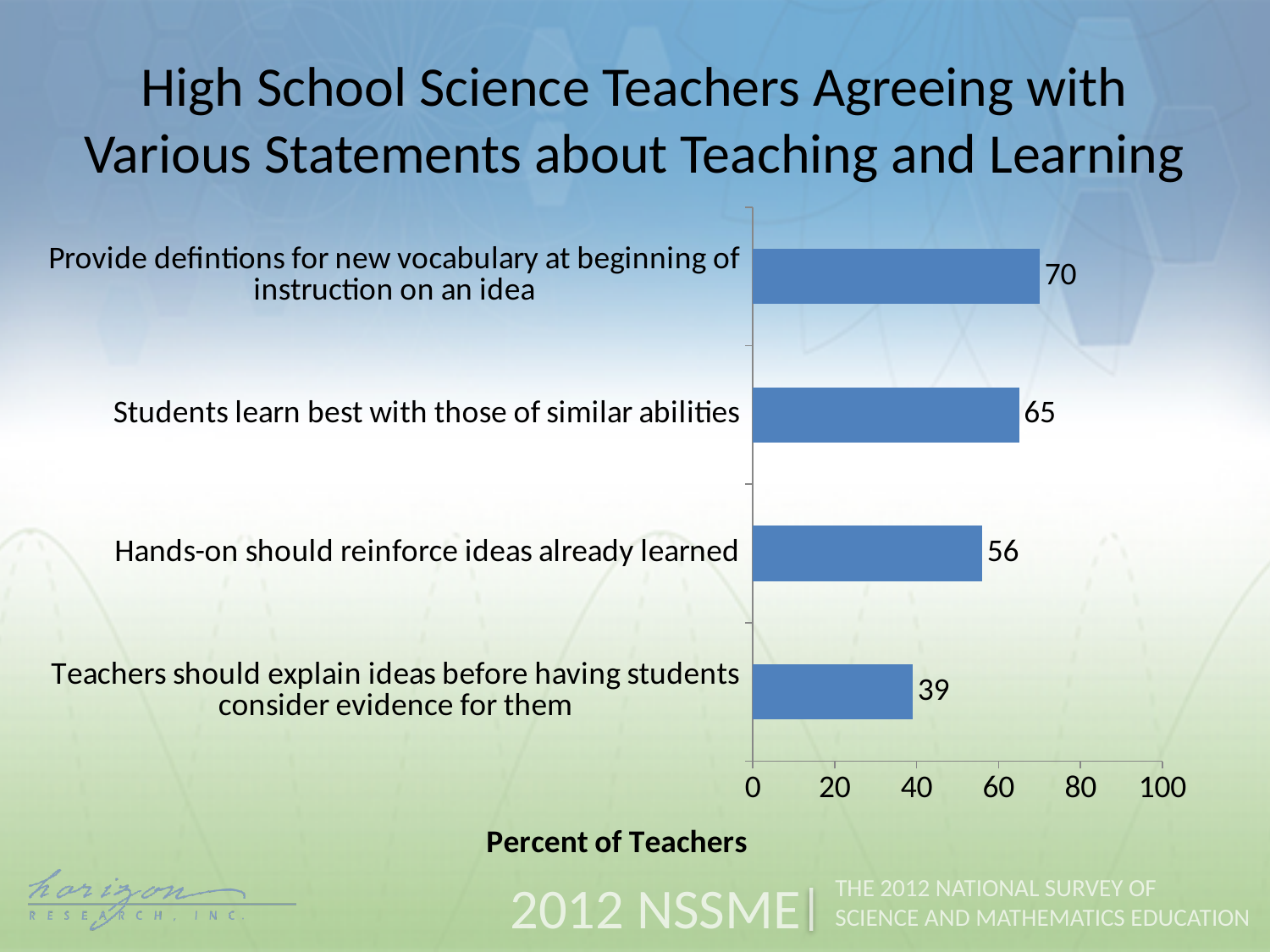
What percent of teachers agree that teachers should explain ideas before having students consider evidence for them? 39 What is the label of the horizontal axis? Percent of Teachers How many statements are shown in the chart? 4 What percent of teachers agree that students learn best with those of similar abilities? 65 Which statement has the lowest percent of teachers agreeing? Teachers should explain ideas before having students consider evidence for them What percent of teachers agree that they should provide definitions for new vocabulary at the beginning of instruction on an idea? 70 What percent of teachers agree that hands-on should reinforce ideas already learned? 56 What is the difference in percent of teachers between the highest and lowest statements? 31 What is the difference in percent of teachers between 'Students learn best with those of similar abilities' and 'Hands-on should reinforce ideas already learned'? 9 Which statement has the highest percent of teachers agreeing? Provide defintions for new vocabulary at beginning of instruction on an idea Which has a larger percent of teachers agreeing: 'Hands-on should reinforce ideas already learned' or 'Teachers should explain ideas before having students consider evidence for them'? Hands-on should reinforce ideas already learned What kind of chart is shown on the slide? Bar chart